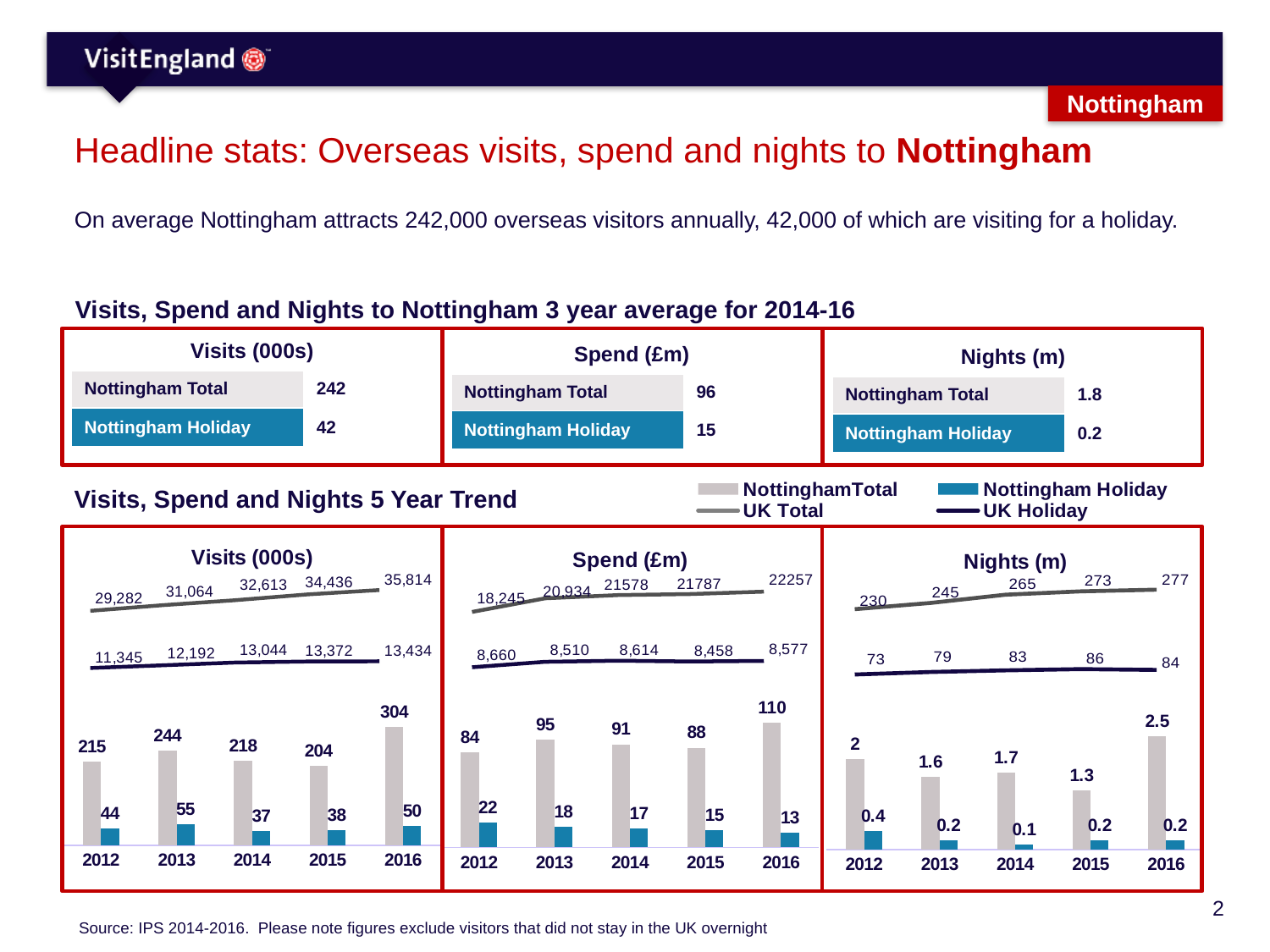
In the Spend (£m) 5 year trend chart, what is the UK Holiday value for 2014? 8,614 In the Spend (£m) 5 year trend chart, which year has the lowest Nottingham Total value? 2012 In the Visits (000s) 5 year trend chart, what is the difference between the Nottingham Total values for 2016 and 2015? 100 In the Spend (£m) 5 year trend chart, does the Nottingham Holiday value rise or fall from 2012 to 2016? fall In the Nights (m) 5 year trend chart, which is larger, the Nottingham Total value for 2012 or for 2015? 2012 How many series does the legend for the 5 Year Trend charts list? 4 How many years are shown on the x axis of the Nights (m) 5 year trend chart? 5 In the Spend (£m) 5 year trend chart, what is the Nottingham Holiday value for 2016? 13 In the Visits (000s) 5 year trend chart, which year has the highest Nottingham Holiday value? 2013 In the Nights (m) 5 year trend chart, what is the Nottingham Total value for 2016? 2.5 In the Visits (000s) 5 year trend chart, what is the Nottingham Total value for 2016? 304 In the Visits (000s) 5 year trend chart, what is the UK Total value for 2012? 29,282